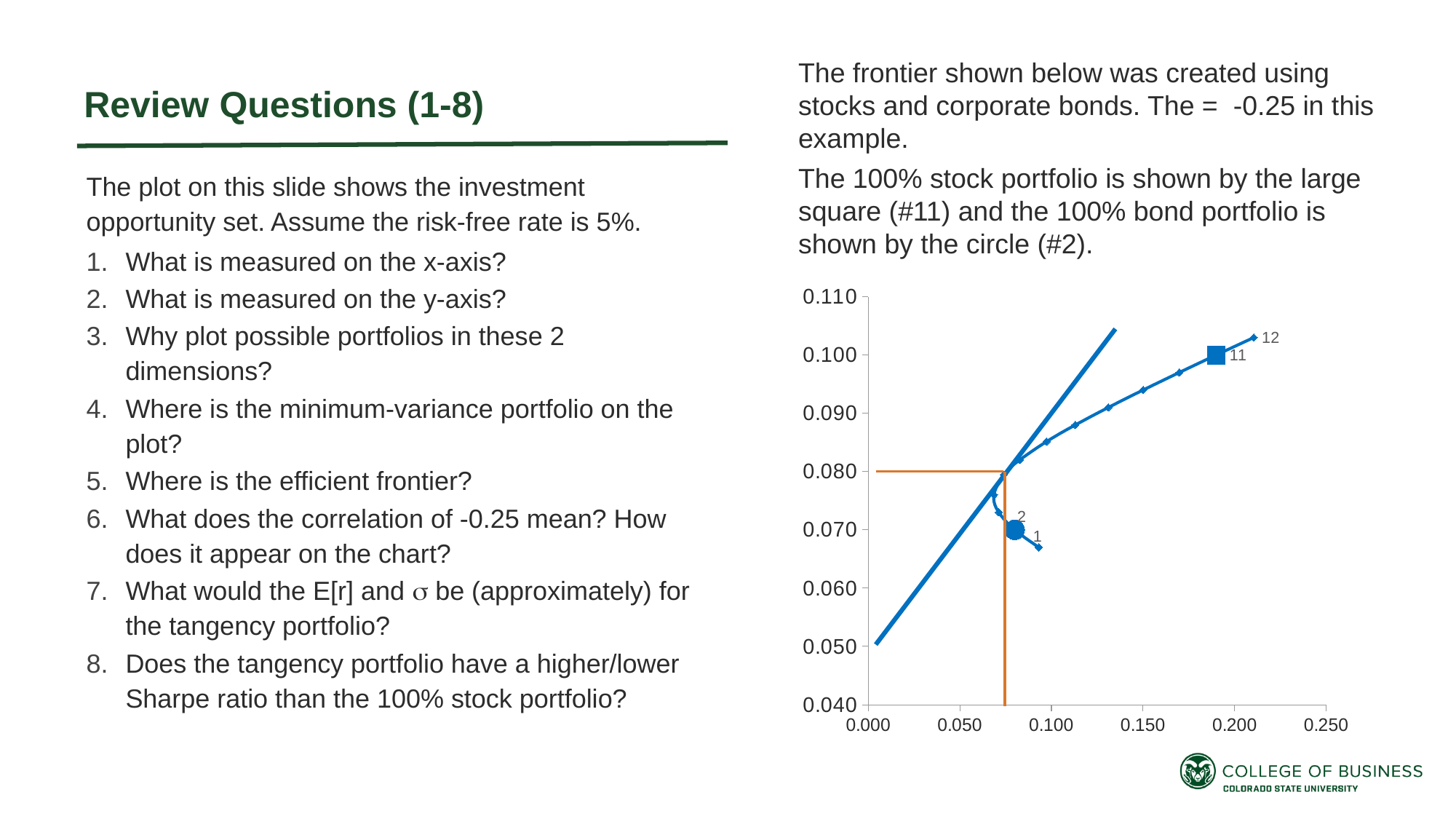
Which labeled point on the chart has the highest expected return (y value)? 12 What is the highest value shown on the x-axis? 0.250 Which has the higher y value, point 11 or point 12? 12 At what y-axis value does the horizontal orange line meet the y-axis? 0.080 Which numbered point is drawn as a large square? 11 Which labeled point on the chart has the lowest expected return (y value)? 1 Is the y value of point 12 greater or less than 0.100? greater Is the x value of point 12 greater or less than 0.200? greater Which has the higher y value, point 1 or point 2? 2 How many points on the chart are labeled with a number? 4 Is the y value of point 1 greater or less than 0.070? less